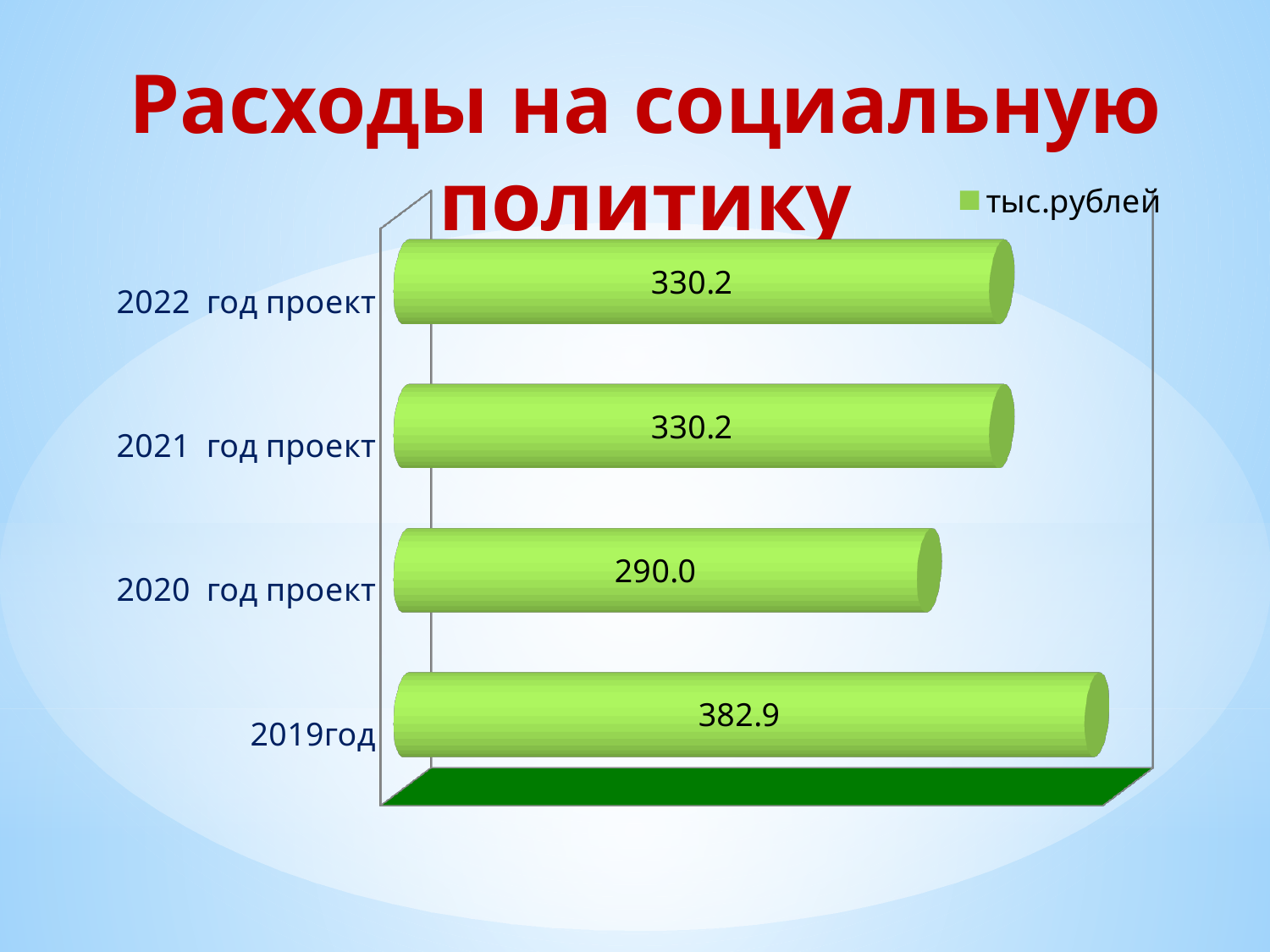
What is the value for 2020 год проект? 290.0 What is the difference between the values for 2021 год проект and 2020 год проект? 40.2 Which is larger, the value for 2019год or the value for 2022 год проект? 2019год What kind of chart is shown on the slide? Bar chart Which category has the highest value? 2019год Which category has the lowest value? 2020 год проект How many categories are shown in the chart? 4 What is the value for 2022 год проект? 330.2 What is the difference between the values for 2019год and 2020 год проект? 92.9 What is the value for 2019год? 382.9 What is the value for 2021 год проект? 330.2 How many series does the legend list? 1